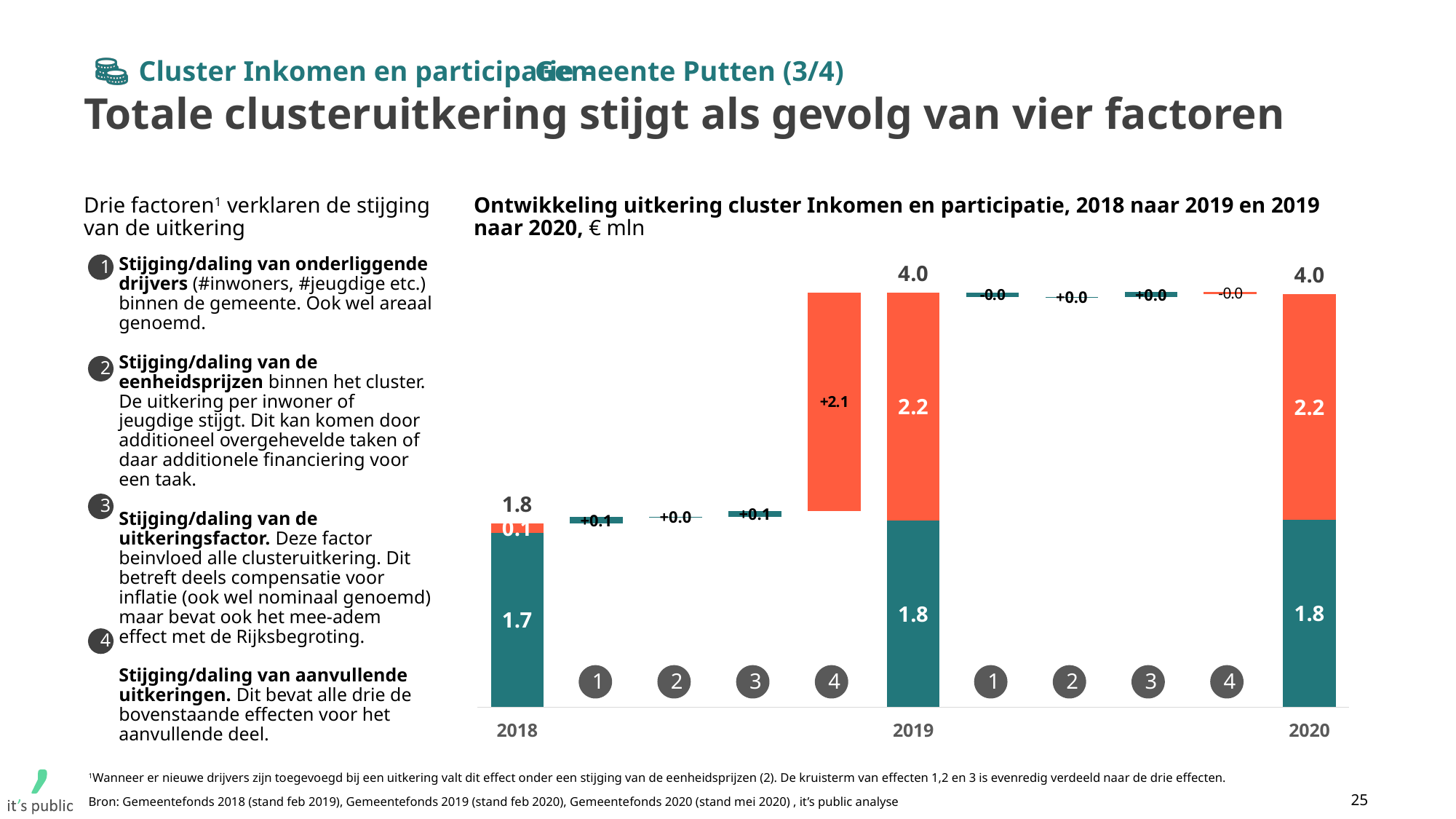
What is the value of the orange (upper) segment of the 2019 bar? 2.2 What is the total uitkering shown for 2018? 1.8 What kind of chart is shown on the slide? Bar chart (waterfall) In what unit are the values in the chart expressed? € mln What is the difference between the 2019 total and the 2018 total? 2.2 What is the total uitkering shown for 2019? 4.0 What is the value of the step for factor 1 between 2018 and 2019? +0.1 What is the total uitkering shown for 2020? 4.0 Which year has the larger total, 2018 or 2019? 2019 Which factor contributes the largest step between 2018 and 2019? 4 What is the value of the teal (lower) segment of the 2018 bar? 1.7 What is the value of the step for factor 4 between 2018 and 2019? +2.1